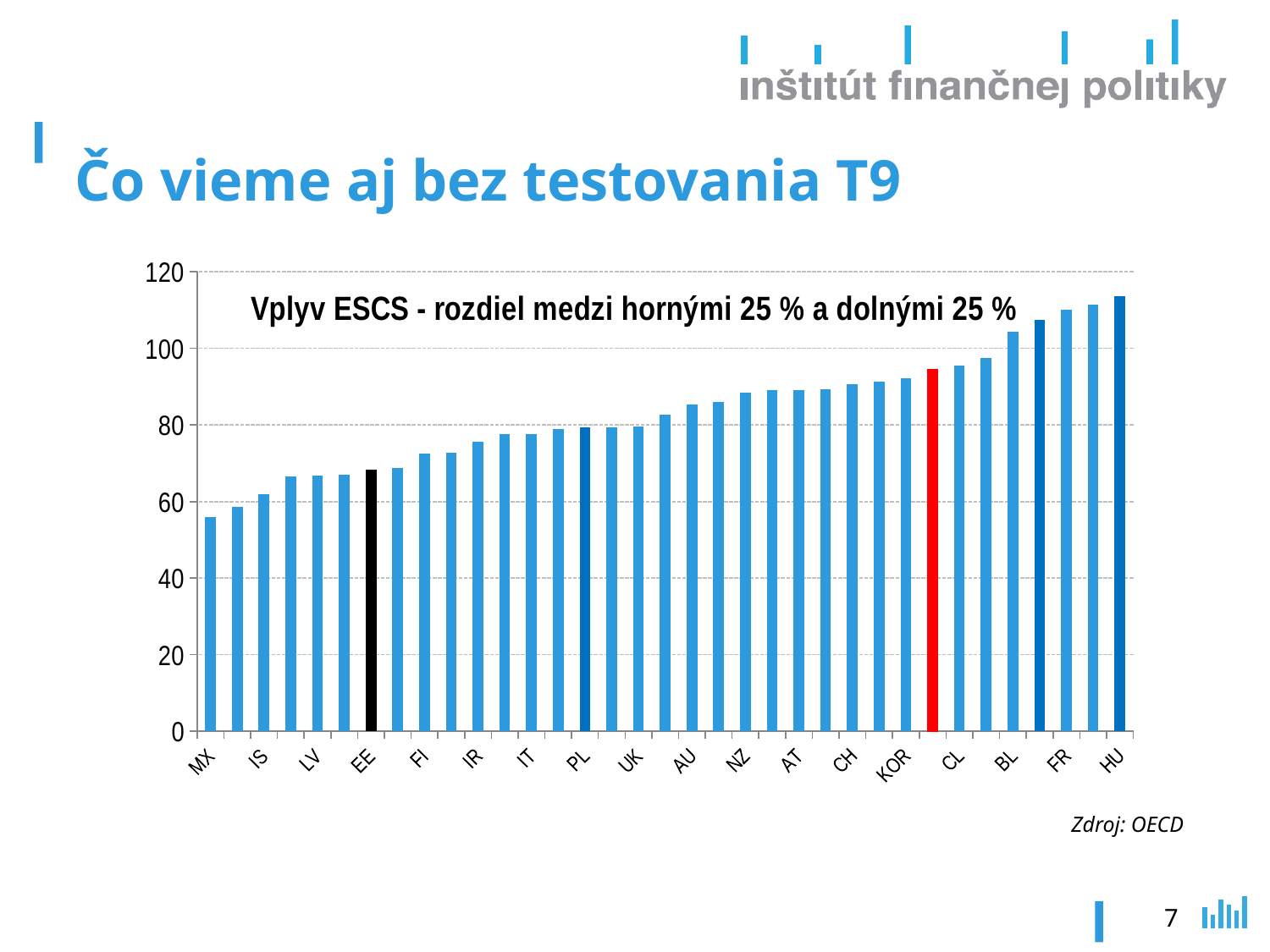
Do the values rise or fall moving from left to right along the x axis? rise Which has a larger value, FR or FI? FR Is the value for EE greater or less than 80? less Is the value for KOR greater or less than 80? greater Is the value for MX greater or less than 60? less What is the title of the chart? Vplyv ESCS - rozdiel medzi hornými 25 % a dolnými 25 % Which category's bar is coloured black? EE Which category has the highest value in the chart? HU Which category has the lowest value in the chart? MX What kind of chart is shown on the slide? bar chart